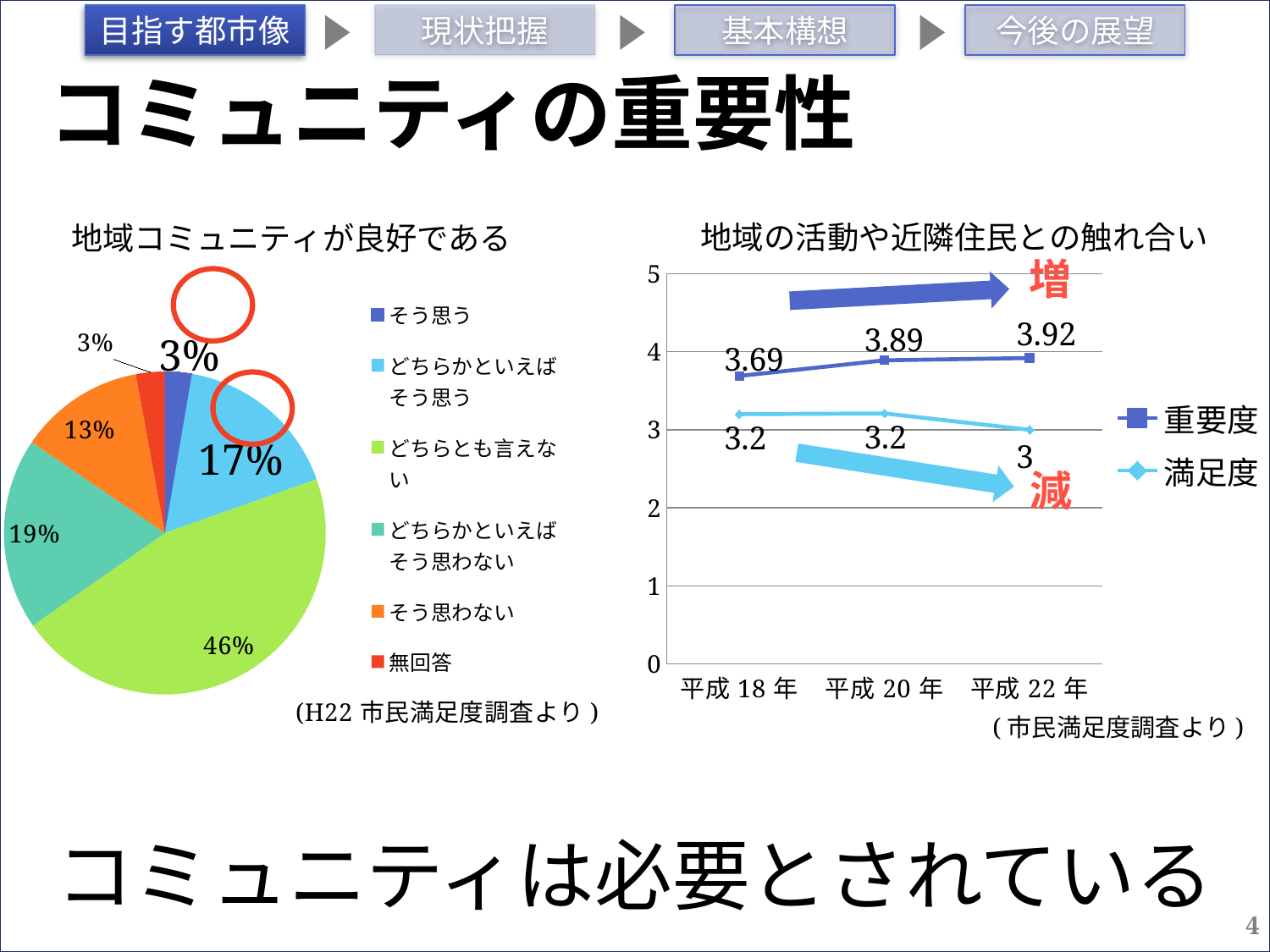
In the line chart titled 地域の活動や近隣住民との触れ合い, what is the value of 満足度 for 平成22年? 3 In the line chart titled 地域の活動や近隣住民との触れ合い, how many series does the legend list? 2 In the pie chart titled 地域コミュニティが良好である, what percentage is shown for どちらとも言えない? 46% In the pie chart titled 地域コミュニティが良好である, what is the difference between the shares for どちらかといえばそう思う and そう思わない? 4% In the pie chart titled 地域コミュニティが良好である, how many categories does the legend list? 6 In the line chart titled 地域の活動や近隣住民との触れ合い, what is the difference between 重要度 and 満足度 in 平成22年? 0.92 In the line chart titled 地域の活動や近隣住民との触れ合い, does 重要度 rise or fall from 平成18年 to 平成22年? rise In the pie chart titled 地域コミュニティが良好である, which category has the largest share? どちらとも言えない What kind of chart is the one titled 地域の活動や近隣住民との触れ合い? line chart In the pie chart titled 地域コミュニティが良好である, what percentage is shown for どちらかといえばそう思わない? 19% In the line chart titled 地域の活動や近隣住民との触れ合い, what is the value of 重要度 for 平成20年? 3.89 In the pie chart titled 地域コミュニティが良好である, which is larger: the share for どちらかといえばそう思わない or the share for そう思わない? どちらかといえばそう思わない